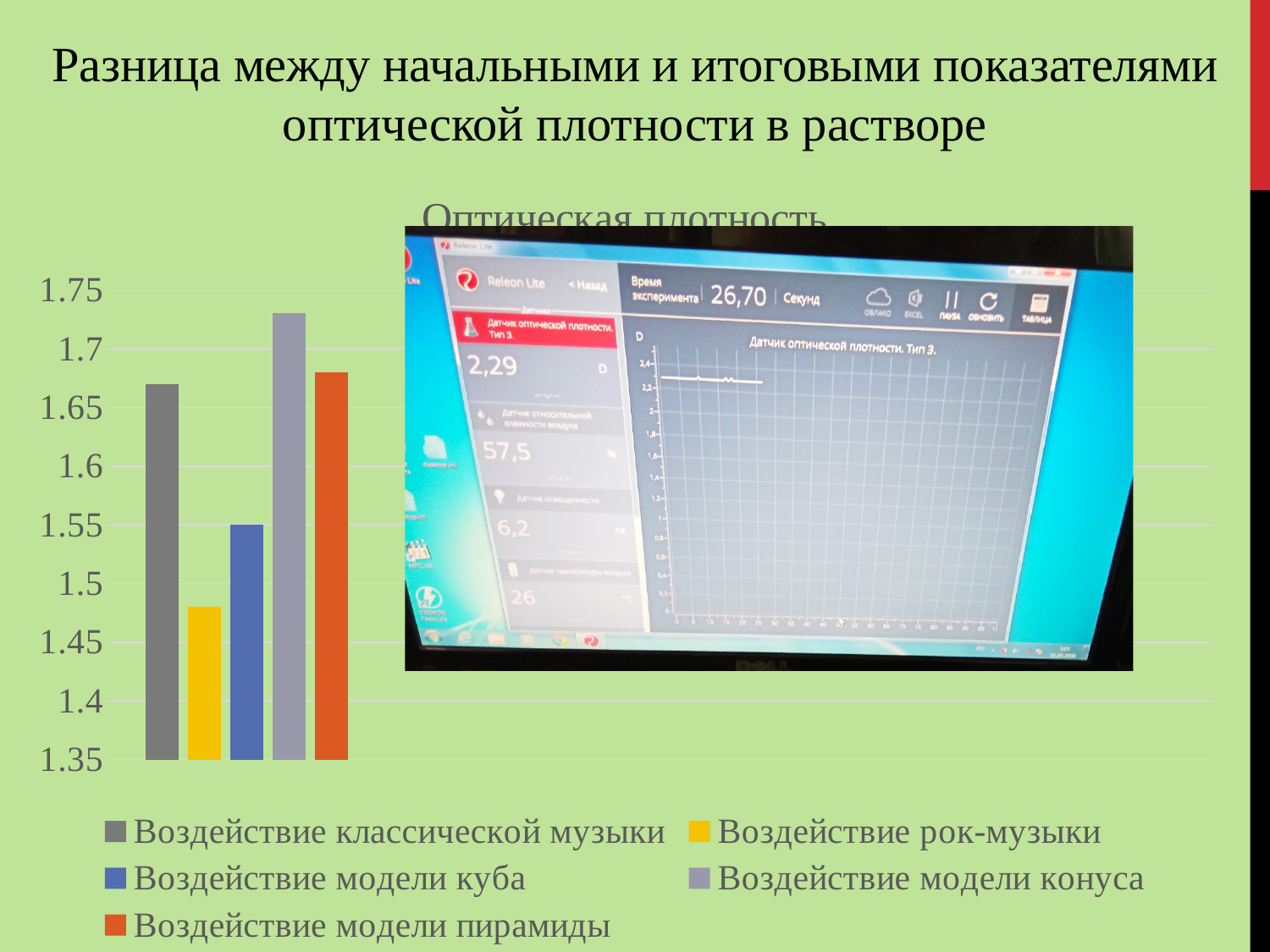
What kind of chart is shown on the slide? bar chart What colour is the bar for Воздействие рок-музыки? yellow Is the value for Воздействие модели куба greater or less than 1.6? less Is the value for Воздействие модели конуса greater or less than 1.7? greater How many series does the legend of the chart list? 5 Which series has the lowest bar in the chart? Воздействие рок-музыки Is the value for Воздействие классической музыки greater or less than 1.6? greater How many bars are plotted in the chart? 5 Which is larger, the value for Воздействие классической музыки or the value for Воздействие модели куба? Воздействие классической музыки Which series has the highest bar in the chart? Воздействие модели конуса